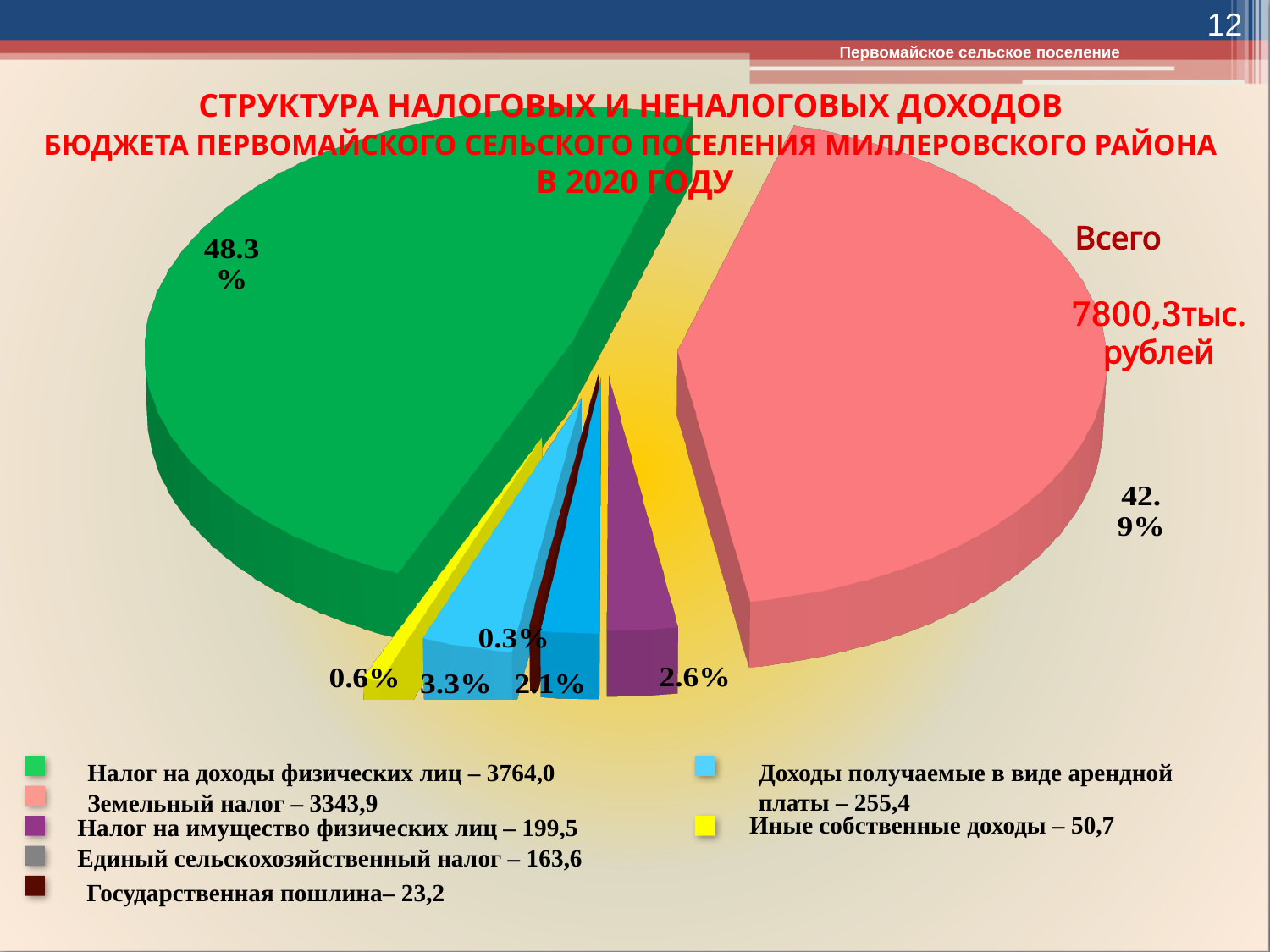
What is the total ("Всего") shown on the slide? 7800,3 тыс. рублей What is the difference in percentage points between the green slice (48.3%) and the pink slice (42.9%)? 5.4 percentage points Which category has the smallest share of the pie? Государственная пошлина What kind of chart is shown on the slide? Pie chart What share of the pie does "Налог на доходы физических лиц" (green slice) represent? 48.3% What share of the pie does "Земельный налог" (pink slice) represent? 42.9% Which is larger according to the legend: "Налог на имущество физических лиц" or "Доходы получаемые в виде арендной платы"? Доходы получаемые в виде арендной платы According to the legend, what is the value for "Иные собственные доходы"? 50,7 What colour is the slice for "Земельный налог"? Pink Which category has the largest share of the pie? Налог на доходы физических лиц How many categories does the legend list? 7 According to the legend, what is the value for "Земельный налог"? 3343,9